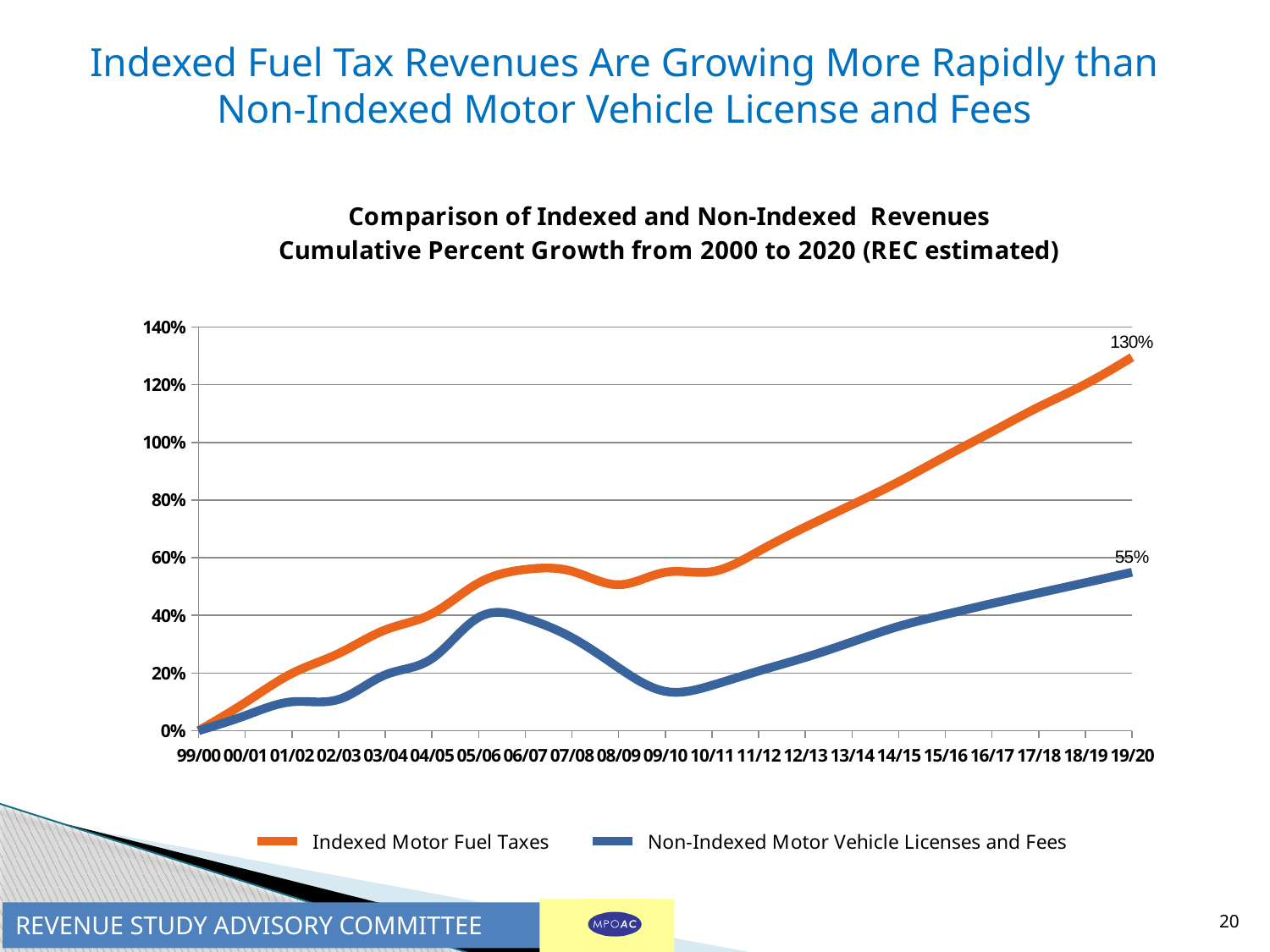
What is the cumulative percent growth for Non-Indexed Motor Vehicle Licenses and Fees in 19/20? 55% Is the value for Indexed Motor Fuel Taxes in 12/13 greater or less than 60%? greater Does the Indexed Motor Fuel Taxes series rise or fall from 10/11 to 19/20? Rise Is the value for Indexed Motor Fuel Taxes in 05/06 greater or less than 40%? greater Which series has the higher value in 19/20, Indexed Motor Fuel Taxes or Non-Indexed Motor Vehicle Licenses and Fees? Indexed Motor Fuel Taxes How many fiscal years are shown on the x axis of the chart? 21 Is the value for Non-Indexed Motor Vehicle Licenses and Fees in 09/10 greater or less than 20%? less What colour is the line for Non-Indexed Motor Vehicle Licenses and Fees? Blue What kind of chart is shown on the slide? Line chart What is the difference between the 19/20 values for Indexed Motor Fuel Taxes and Non-Indexed Motor Vehicle Licenses and Fees? 75% What is the cumulative percent growth for Indexed Motor Fuel Taxes in 19/20? 130% How many series does the chart's legend list? 2